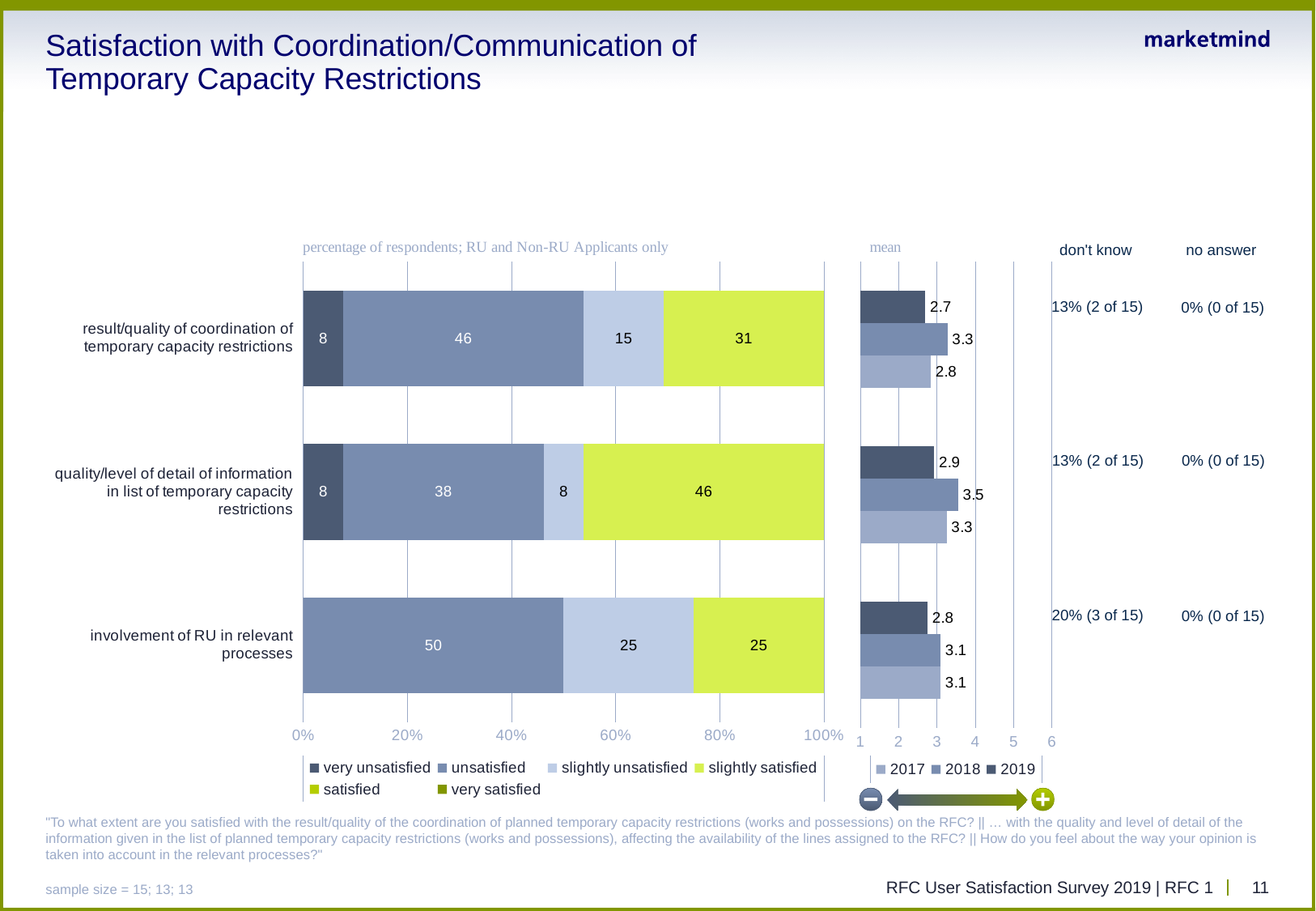
In the mean chart, what is the 2019 mean for result/quality of coordination of temporary capacity restrictions? 2.7 How many items (categories) are shown in the stacked percentage chart? 3 In the mean chart, which item has the lowest 2019 mean? result/quality of coordination of temporary capacity restrictions In the stacked percentage chart, what percentage of respondents were 'slightly satisfied' with the quality/level of detail of information in the list of temporary capacity restrictions? 46 In the stacked percentage chart, what percentage of respondents were 'unsatisfied' with the result/quality of coordination of temporary capacity restrictions? 46 How many series does the legend of the mean chart list? 3 In the mean chart, what is the 2018 mean for quality/level of detail of information in list of temporary capacity restrictions? 3.5 In the mean chart, which item has the highest 2019 mean? quality/level of detail of information in list of temporary capacity restrictions In the stacked percentage chart, which is larger for involvement of RU in relevant processes: the 'unsatisfied' share or the 'slightly satisfied' share? unsatisfied In the stacked percentage chart, what percentage of respondents were 'unsatisfied' with the involvement of RU in relevant processes? 50 In the mean chart, what is the difference between the 2018 and 2019 means for result/quality of coordination of temporary capacity restrictions? 0.6 What type of chart is the percentage-of-respondents chart on the left? stacked bar chart